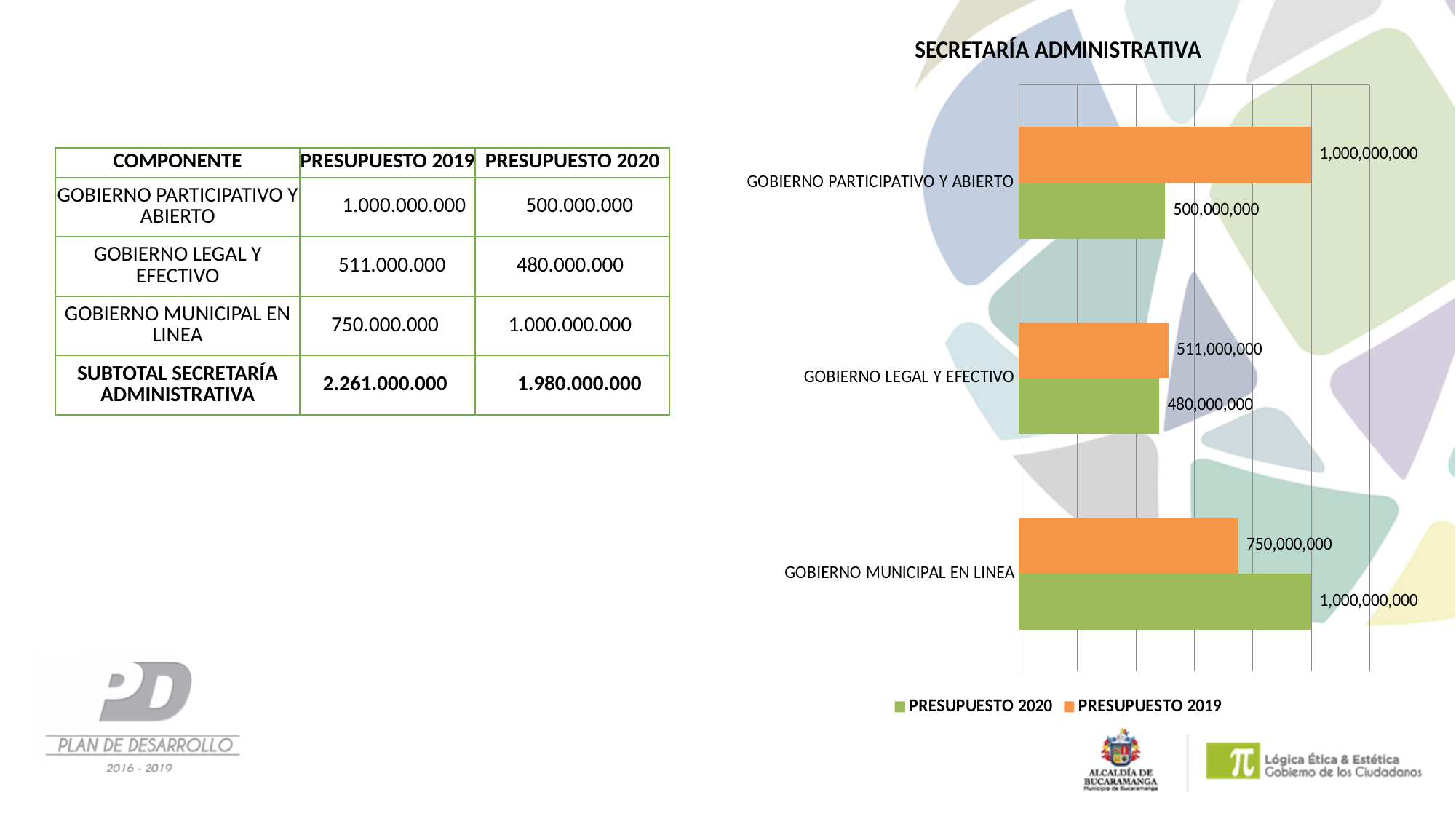
What is the difference between the PRESUPUESTO 2020 and PRESUPUESTO 2019 values for GOBIERNO MUNICIPAL EN LINEA? 250,000,000 For GOBIERNO LEGAL Y EFECTIVO, which is larger: PRESUPUESTO 2019 or PRESUPUESTO 2020? PRESUPUESTO 2019 What is the PRESUPUESTO 2019 value for GOBIERNO PARTICIPATIVO Y ABIERTO? 1,000,000,000 What is the PRESUPUESTO 2020 value for GOBIERNO PARTICIPATIVO Y ABIERTO? 500,000,000 Which category has the highest PRESUPUESTO 2020 value? GOBIERNO MUNICIPAL EN LINEA Which category has the lowest PRESUPUESTO 2019 value? GOBIERNO LEGAL Y EFECTIVO How many series does the legend list? 2 What is the difference between the PRESUPUESTO 2019 and PRESUPUESTO 2020 values for GOBIERNO PARTICIPATIVO Y ABIERTO? 500,000,000 What is the PRESUPUESTO 2020 value for GOBIERNO LEGAL Y EFECTIVO? 480,000,000 What is the PRESUPUESTO 2019 value for GOBIERNO MUNICIPAL EN LINEA? 750,000,000 How many categories are shown in the chart? 3 What kind of chart is shown on the slide? Bar chart